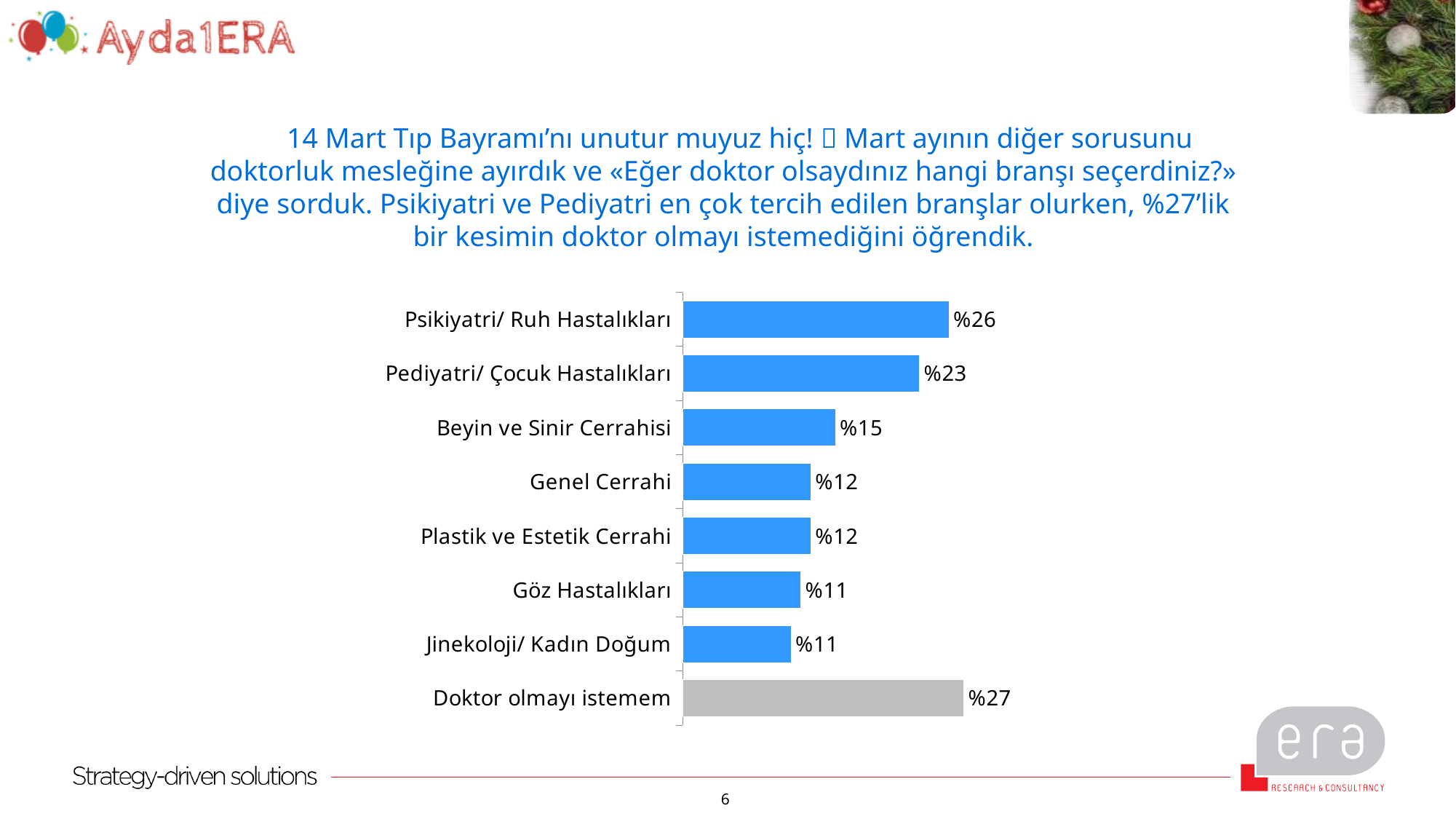
Which category has the highest value? Doktor olmayı istemem What is the difference between the values for Psikiyatri/ Ruh Hastalıkları and Pediyatri/ Çocuk Hastalıkları? 3 percentage points How many categories are shown in the chart? 8 What is the value for Doktor olmayı istemem? %27 What is the difference between the values for Doktor olmayı istemem and Göz Hastalıkları? 16 percentage points Which medical branch (excluding Doktor olmayı istemem) has the highest value? Psikiyatri/ Ruh Hastalıkları What is the value for Beyin ve Sinir Cerrahisi? %15 What is the value for Psikiyatri/ Ruh Hastalıkları? %26 What is the value for Jinekoloji/ Kadın Doğum? %11 What kind of chart is shown on the slide? Bar chart Which is larger, the value for Beyin ve Sinir Cerrahisi or the value for Genel Cerrahi? Beyin ve Sinir Cerrahisi Which bar is coloured differently from the others? Doktor olmayı istemem